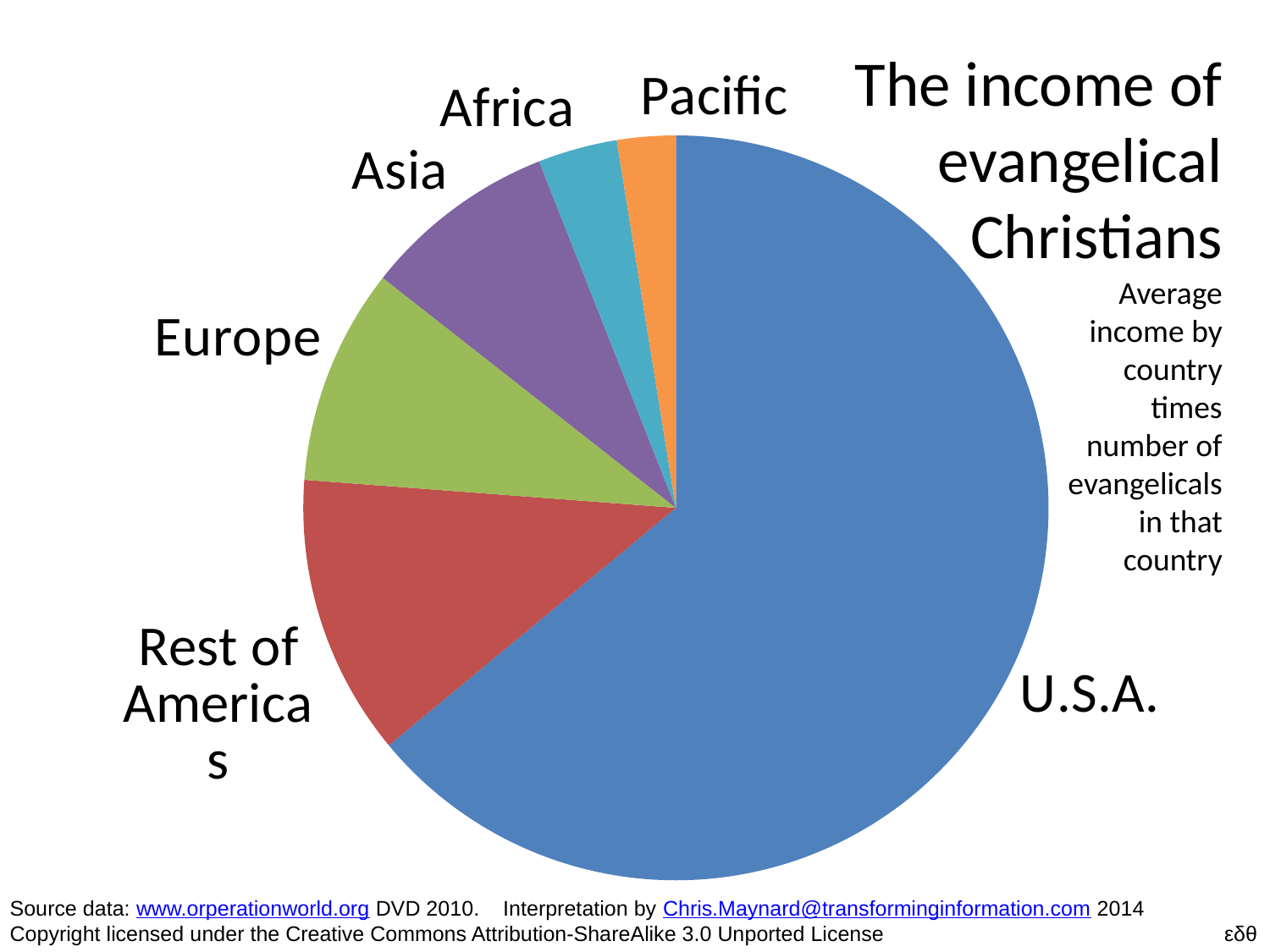
Which slice is larger, Asia or Africa? Asia What colour is the U.S.A. slice? blue Which slice is larger, Rest of Americas or Asia? Rest of Americas Which slice is larger, Rest of Americas or Europe? Rest of Americas What kind of chart is shown on the slide? pie chart Which region has the largest slice of the pie chart? U.S.A. What is the title of the pie chart? The income of evangelical Christians How many slices does the pie chart have? 6